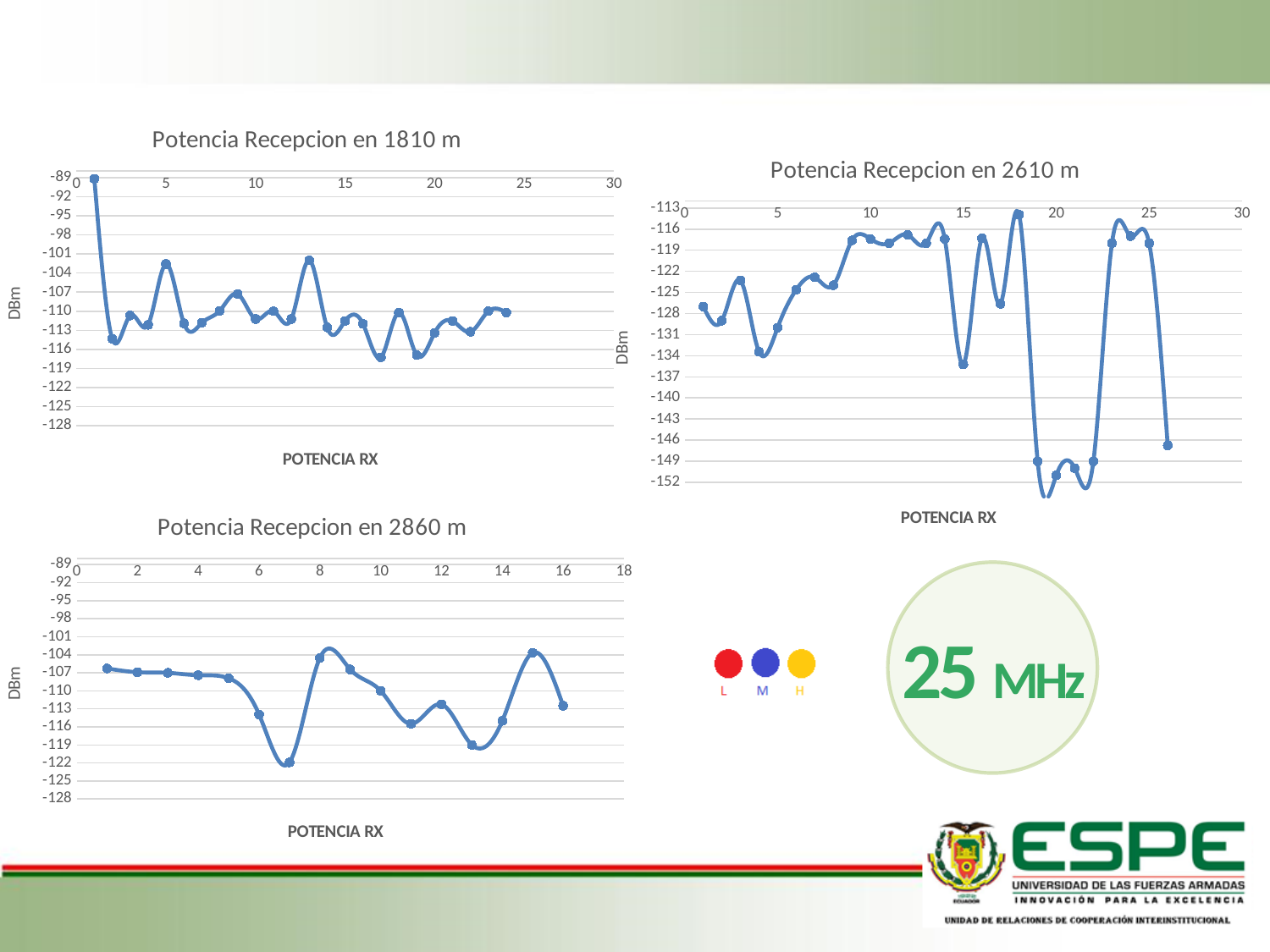
In the chart 'Potencia Recepcion en 2610 m', is the value at x = 18 greater or less than -119? greater In the chart 'Potencia Recepcion en 1810 m', is the value at x = 2 greater or less than -110? less In the chart 'Potencia Recepcion en 1810 m', at which x value is the highest point? 1 What kind of chart is 'Potencia Recepcion en 1810 m'? line chart In the chart 'Potencia Recepcion en 2860 m', is the value at x = 1 greater or less than -110? greater In the chart 'Potencia Recepcion en 2860 m', at which x value is the lowest point? 7 In the chart 'Potencia Recepcion en 2610 m', what is the y-axis label? DBm How many charts are shown on the slide? 3 In the chart 'Potencia Recepcion en 1810 m', which is larger, the value at x = 1 or the value at x = 2? x = 1